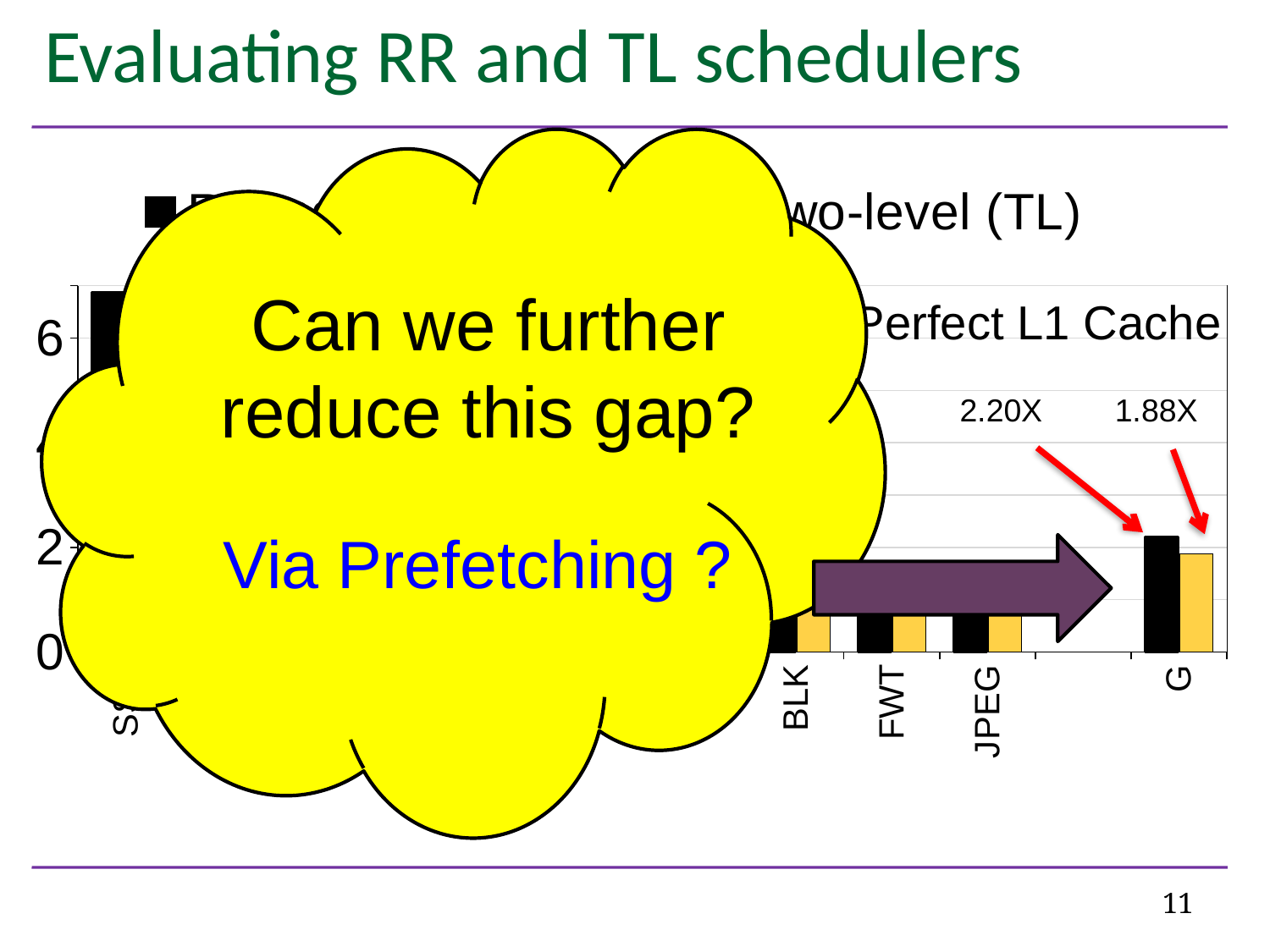
Is the value of the black bar in the rightmost category (labeled G) greater or less than 2? greater How many bars (series) are plotted for each category in the chart? 2 What value is annotated for the yellow bar of the rightmost category (labeled G)? 1.88X Is the value of the black bar for JPEG greater or less than 2? less What value is annotated for the black bar of the rightmost category (labeled G)? 2.20X What kind of chart is shown on the slide? bar chart Is the value of the yellow bar for FWT greater or less than 2? less In the rightmost category (labeled G), which bar is larger, the black bar or the yellow bar? the black bar What is the highest tick value shown on the y axis of the chart? 6 What is the difference between the two annotated values 2.20X and 1.88X in the rightmost category? 0.32X Which is larger, the black bar for BLK or the black bar for the rightmost category (labeled G)? the rightmost category (G)